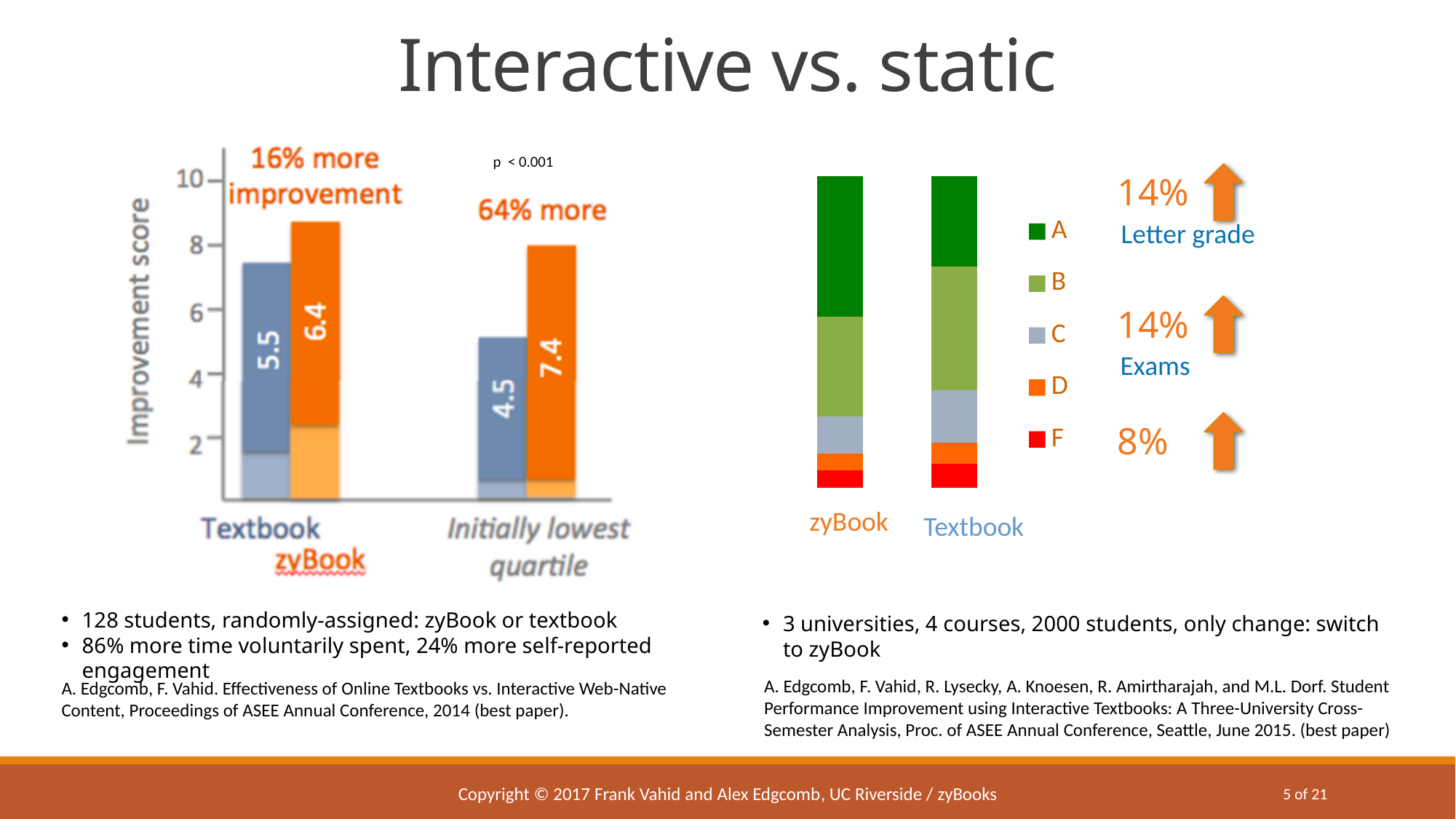
What kind of chart is the left chart (Improvement score)? Bar chart In the left chart (Improvement score), which bar has the lowest improvement score? Textbook, Initially lowest quartile (4.5) In the left chart (Improvement score), what is the difference between the zyBook and Textbook improvement scores in the Initially lowest quartile group? 2.9 In the left chart (Improvement score), what is the improvement score labelled on the Textbook bar in the first group? 5.5 In the left chart (Improvement score), what is the improvement score labelled on the zyBook bar in the first (Textbook / zyBook) group? 6.4 In the left chart (Improvement score), what is the difference between the zyBook (6.4) and Textbook (5.5) improvement scores in the first group? 0.9 In the left chart (Improvement score), which bar has the highest improvement score? zyBook, Initially lowest quartile (7.4) In the left chart (Improvement score), what is the improvement score for the Textbook bar in the Initially lowest quartile group? 4.5 In the left chart (Improvement score), what is the improvement score for the zyBook bar in the Initially lowest quartile group? 7.4 How many letter grades does the legend of the right-hand stacked chart list? 5 In the right-hand stacked chart, what colour represents grade F in the legend? Red In the right-hand stacked chart, which bar has the larger A (green) segment, zyBook or Textbook? zyBook